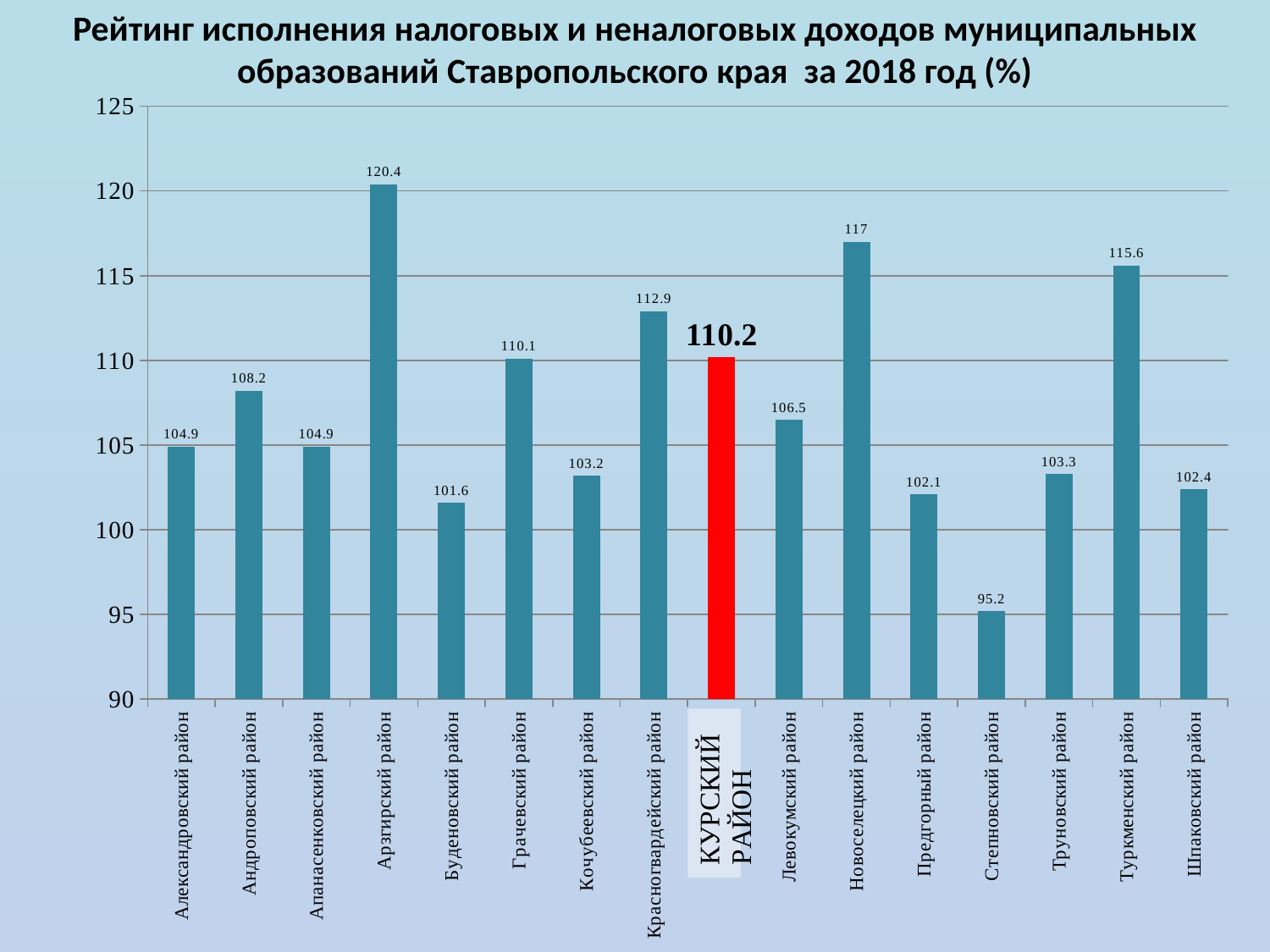
What is the difference between the values for Арзгирский район and Степновский район? 25.2 What is the difference between the values for Новоселецкий район and Туркменский район? 1.4 Is the value for Левокумский район greater or less than 105? greater What is the value for Курский район (the red bar)? 110.2 Which district has the lowest value? Степновский район How many districts are shown on the chart? 16 Which is larger, the value for Красногвардейский район or the value for Курский район? Красногвардейский район What kind of chart is shown on the slide? bar chart What is the value for Арзгирский район? 120.4 Which bar is highlighted in red? Курский район Which district has the highest value? Арзгирский район What is the value for Степновский район? 95.2